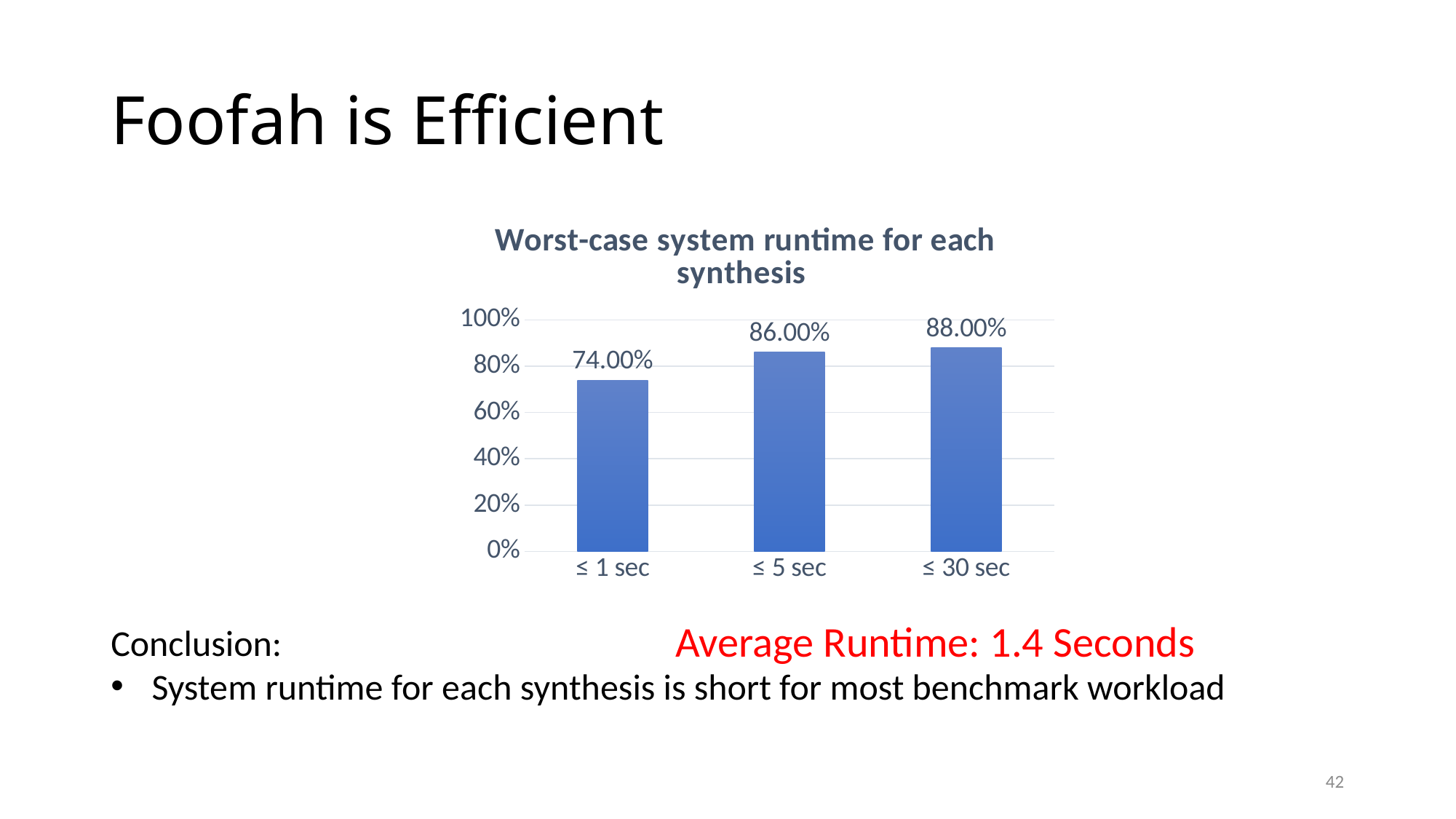
Which is larger, the value for ≤ 5 sec or the value for ≤ 1 sec? ≤ 5 sec What is the value for the ≤ 30 sec category? 88.00% What is the difference between the values for ≤ 5 sec and ≤ 1 sec? 12.00% What is the value for the ≤ 1 sec category? 74.00% What is the value for the ≤ 5 sec category? 86.00% Which category has the lowest value? ≤ 1 sec What is the difference between the values for ≤ 30 sec and ≤ 1 sec? 14.00% How many categories are shown on the x axis? 3 Which category has the highest value? ≤ 30 sec Is the value for ≤ 1 sec greater or less than 80%? less What kind of chart is shown on the slide? bar chart What is the title of the chart? Worst-case system runtime for each synthesis